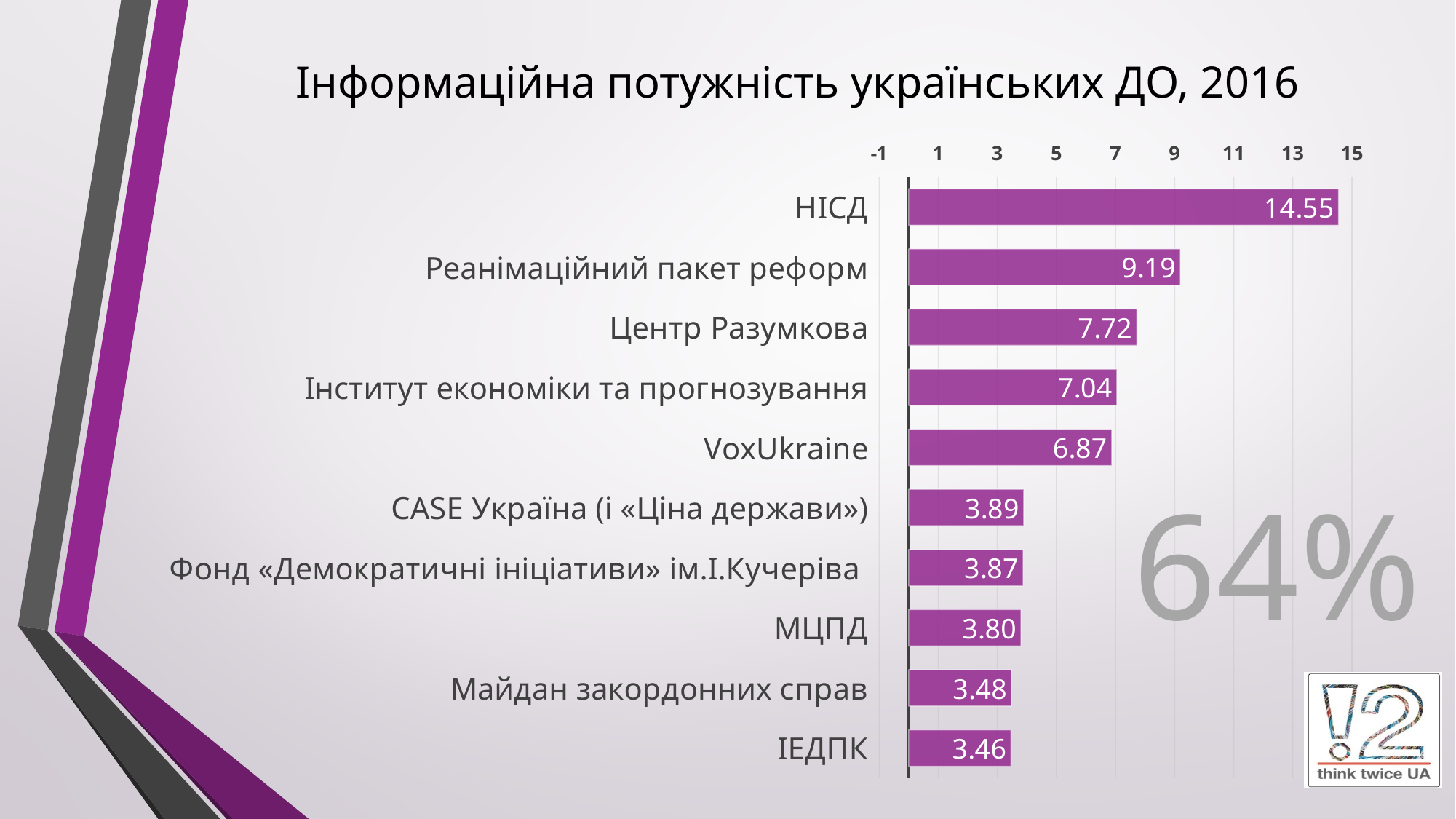
Which is larger, the value for Інститут економіки та прогнозування or the value for VoxUkraine? Інститут економіки та прогнозування Is the value for Реанімаційний пакет реформ greater or less than 7? greater What is the value for НІСД? 14.55 What is the value for Майдан закордонних справ? 3.48 How many categories are shown in the chart? 10 What is the difference between the values for НІСД and Реанімаційний пакет реформ? 5.36 Which category has the lowest value? ІЕДПК Which category has the highest value? НІСД What is the value for Центр Разумкова? 7.72 What is the value for VoxUkraine? 6.87 What is the title of the chart? Інформаційна потужність українських ДО, 2016 What kind of chart is shown on the slide? bar chart